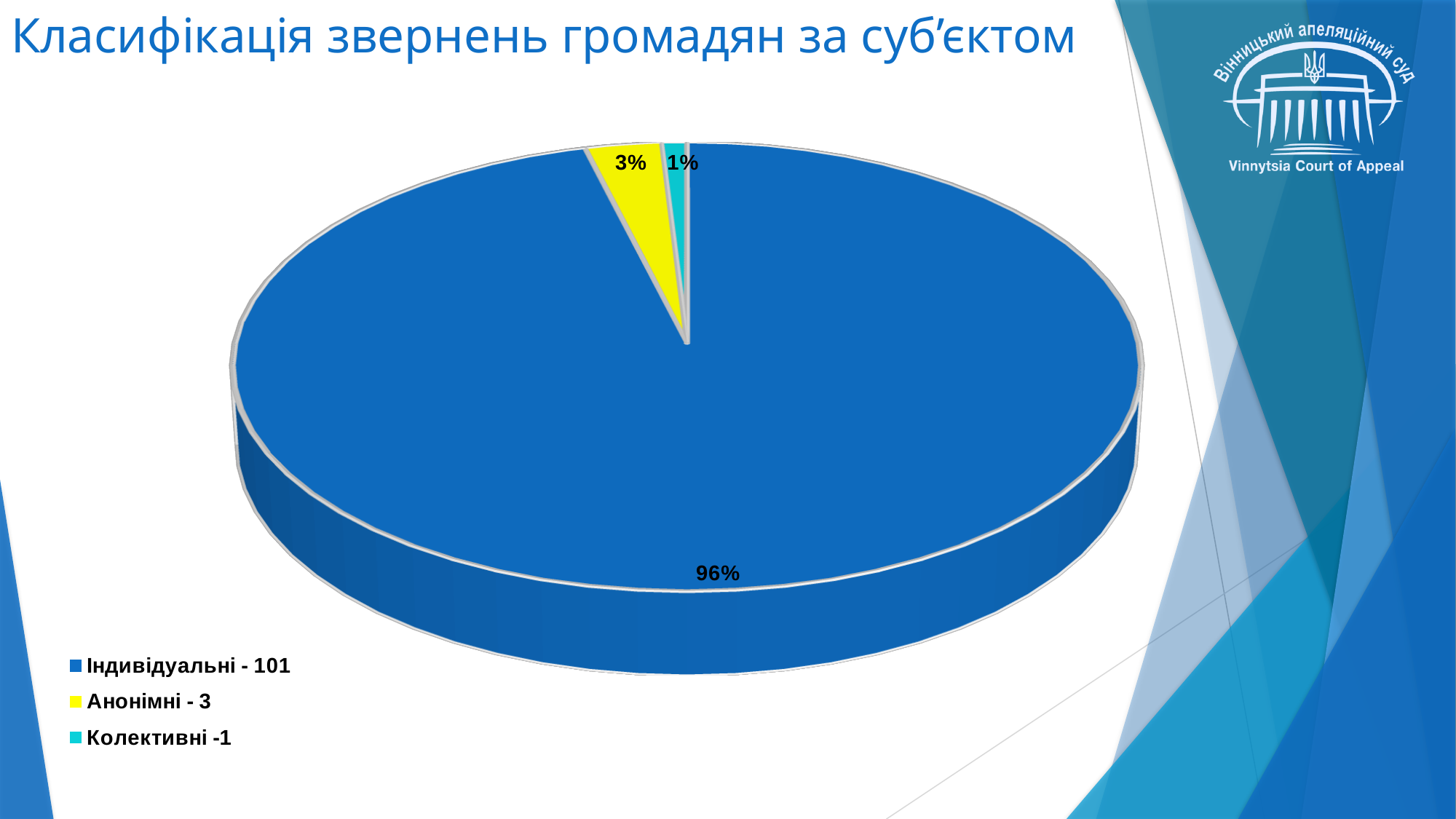
What count is shown in the legend for Індивідуальні? 101 What share of the pie does the Колективні slice represent? 1% What colour is the Анонімні slice in the pie chart? yellow What share of the pie does the Анонімні slice represent? 3% What share of the pie does the Індивідуальні slice represent? 96% Which category has the largest slice of the pie? Індивідуальні What is the title of the chart on the slide? Класифікація звернень громадян за суб’єктом What is the difference in percentage points between the Індивідуальні and Анонімні slices? 93% How many categories does the pie chart show? 3 Which category has the smallest slice of the pie? Колективні What kind of chart is shown on the slide? pie chart Which slice is larger, Анонімні or Колективні? Анонімні